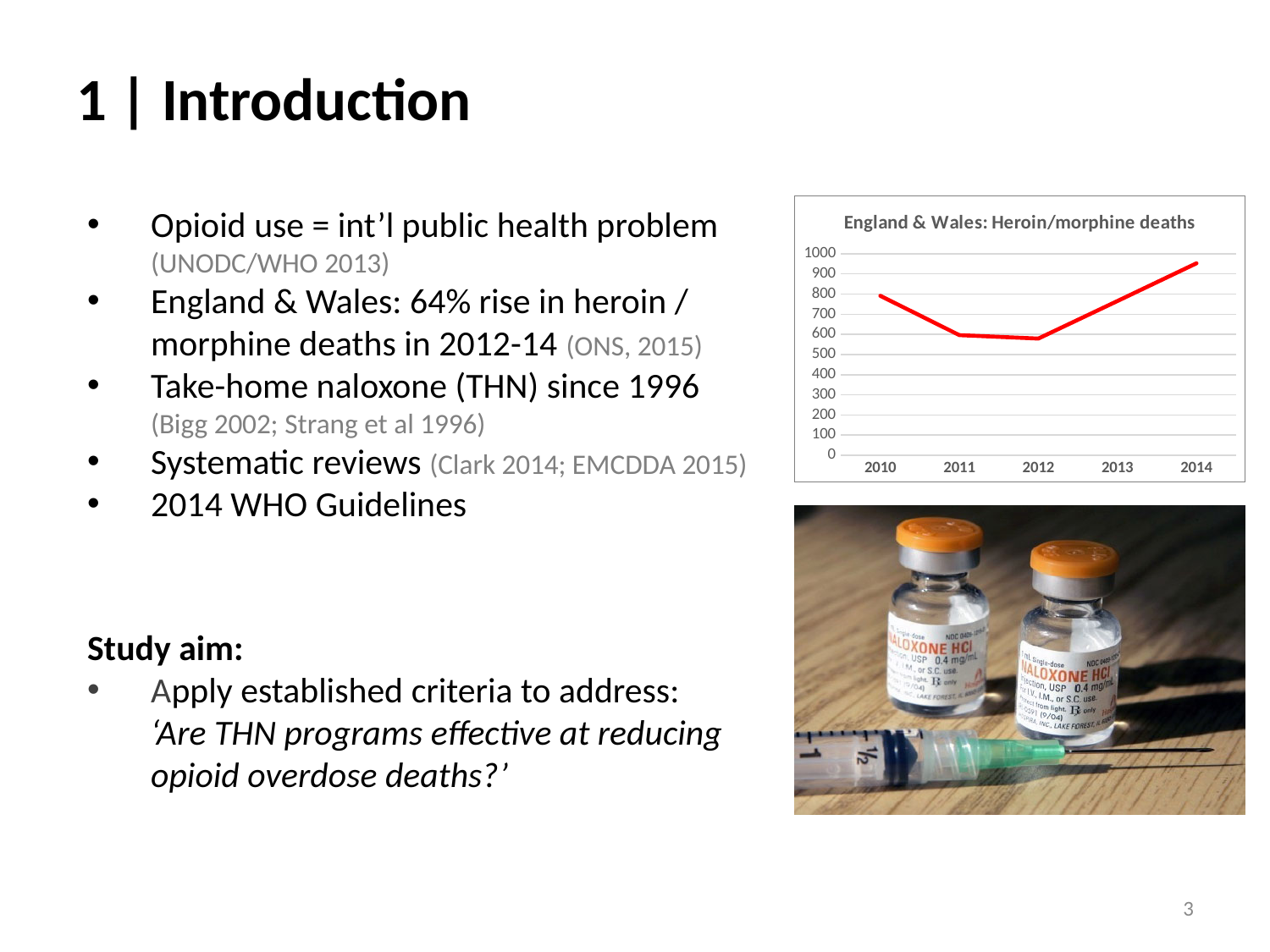
What kind of chart is shown on the slide? line chart Is the value for 2012 greater or less than 500? greater Do the values rise or fall from 2012 to 2014? rise Is the value for 2011 greater or less than 700? less Which year has the larger value, 2010 or 2011? 2010 What is the title of the chart on the slide? England & Wales: Heroin/morphine deaths Which year has the highest number of heroin/morphine deaths in the chart? 2014 How many years are plotted on the x axis of the chart? 5 What colour is the line in the chart? red Is the value for 2014 greater or less than 900? greater Which year has the larger value, 2010 or 2014? 2014